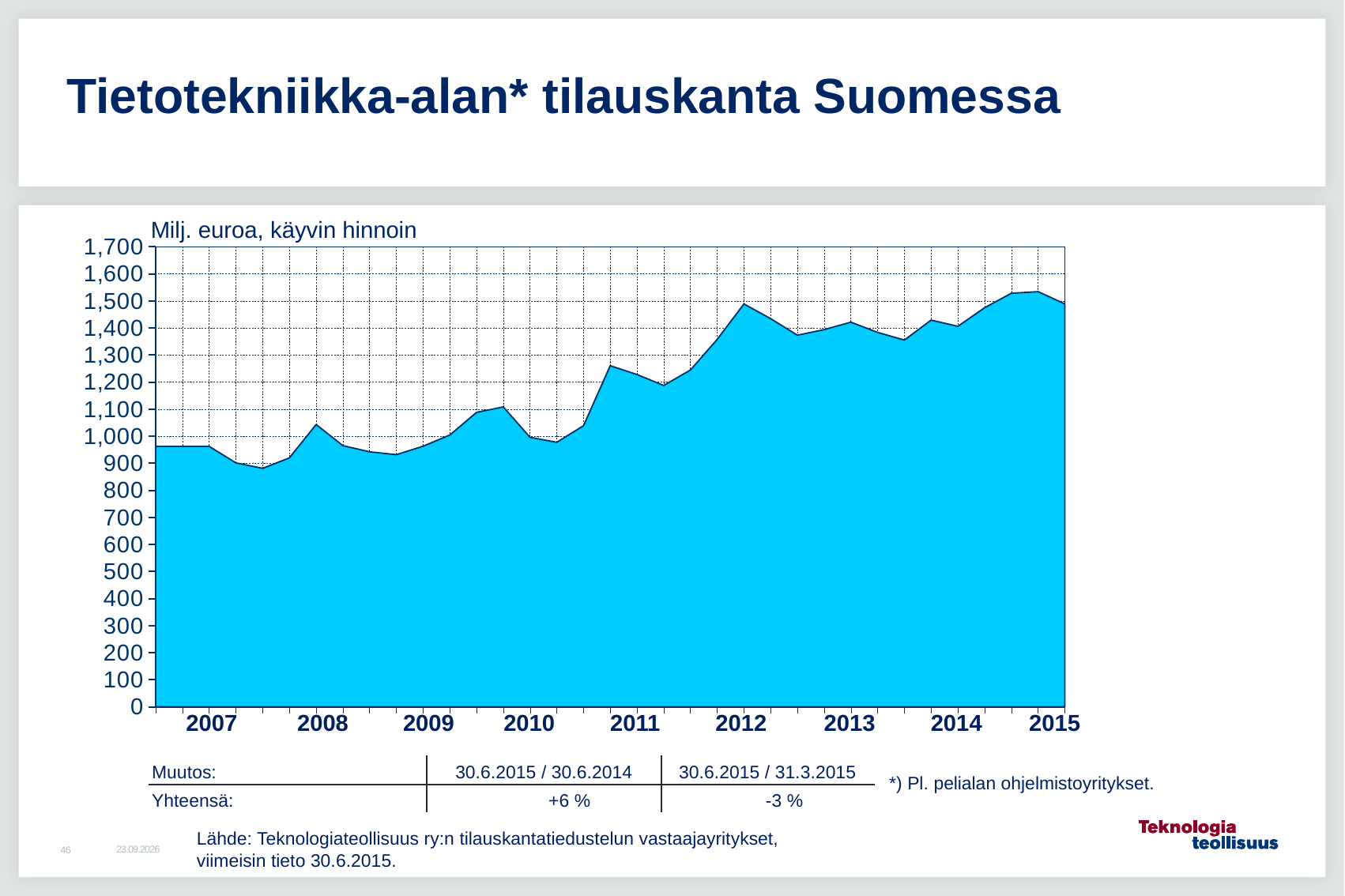
Is the value at the start of 2015 greater or less than 1,400? greater What kind of chart is shown on the slide? area chart Is the value at the start of 2007 greater or less than 1,100? less What is the title of the slide's chart? Tietotekniikka-alan* tilauskanta Suomessa Is the value at the start of 2012 larger or smaller than the value at the start of 2009? larger What is the highest value shown on the y axis of the chart? 1,700 Is the value at the start of 2007 greater or less than 900? greater How many year labels are shown on the x axis of the chart? 9 What unit label is shown above the y axis of the chart? Milj. euroa, käyvin hinnoin Overall, do the values rise or fall from 2007 to 2015? rise